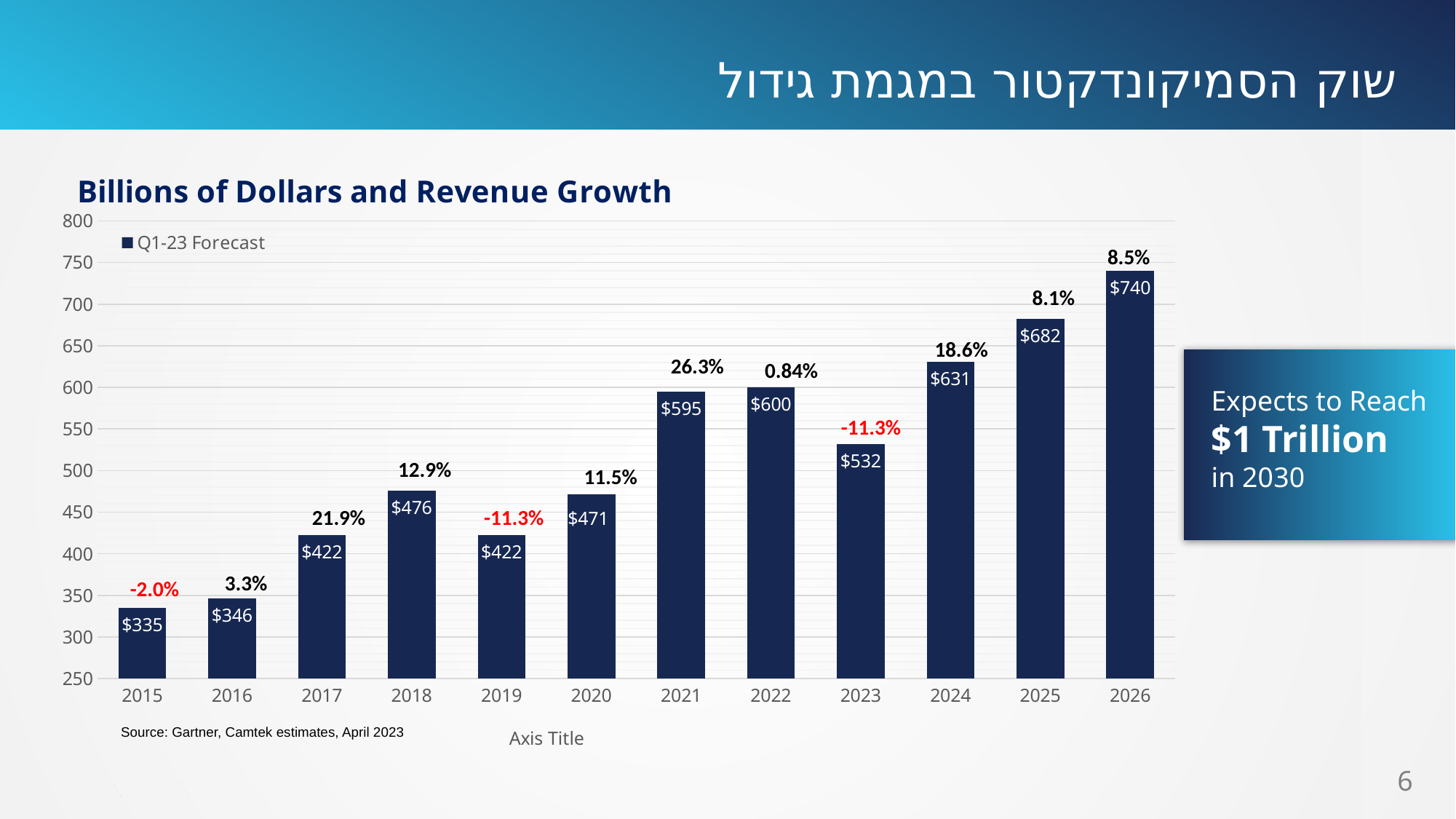
How many years are shown on the x axis? 12 What growth rate is shown above the bar for 2023? -11.3% What kind of chart is shown? bar chart Is the value for 2024 greater or less than 600? greater Which is larger, the value for 2022 or the value for 2023? 2022 Which year has the highest value? 2026 What is the difference between the values for 2026 and 2025? $58 What is the value for 2015? $335 What is the title of the chart? Billions of Dollars and Revenue Growth What is the value for 2021? $595 How many series does the legend list? 1 Which year has the lowest value? 2015